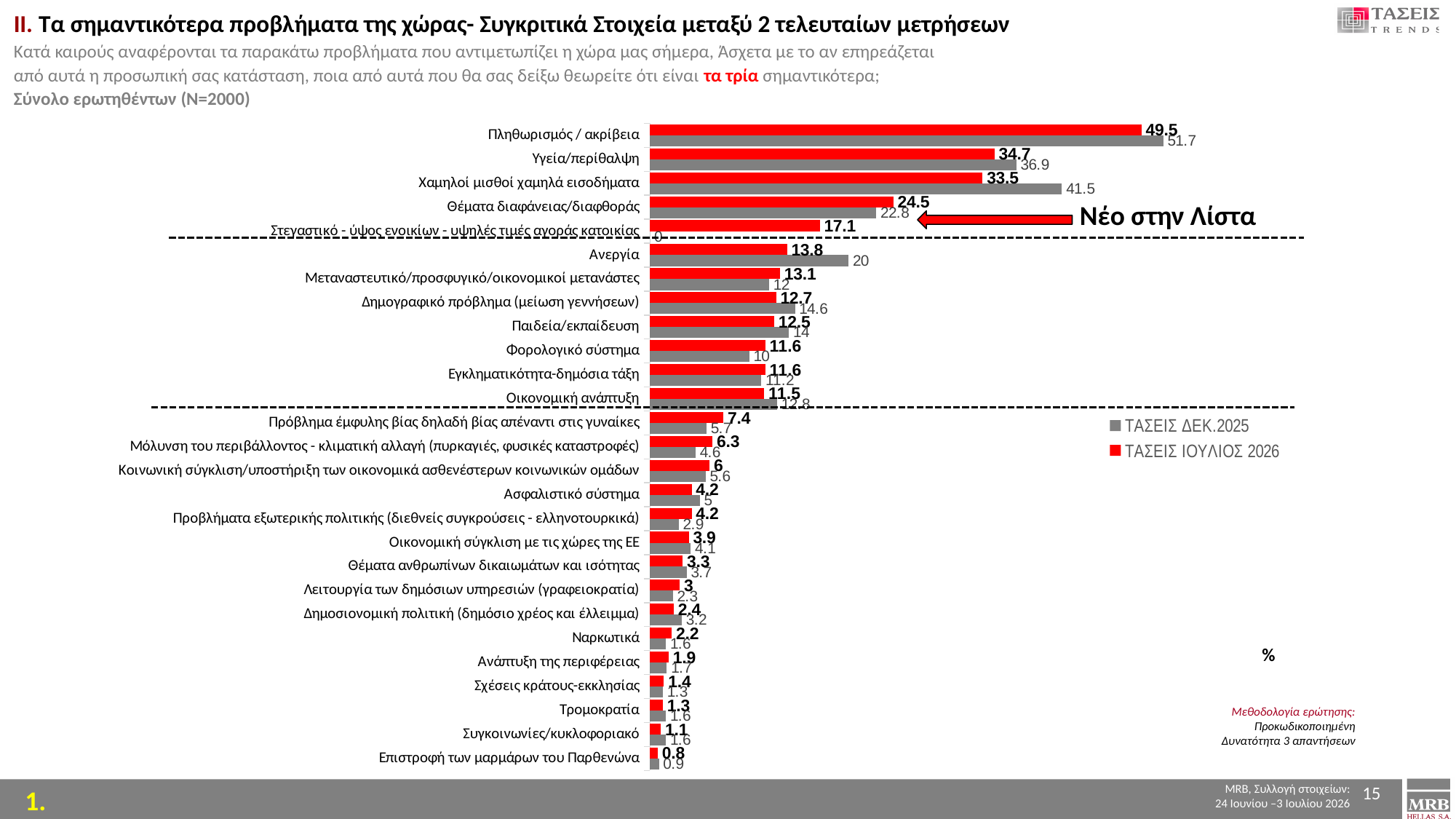
What is the ΤΑΣΕΙΣ ΙΟΥΛΙΟΣ 2026 value for Στεγαστικό - ύψος ενοικίων - υψηλές τιμές αγοράς κατοικίας? 17.1 What type of chart is shown on the slide? bar chart Which category has the lowest ΤΑΣΕΙΣ ΙΟΥΛΙΟΣ 2026 value? Επιστροφή των μαρμάρων του Παρθενώνα How many series does the legend list? 2 What is the difference between the ΤΑΣΕΙΣ ΔΕΚ.2025 and ΤΑΣΕΙΣ ΙΟΥΛΙΟΣ 2026 values for Ανεργία? 6.2 For Θέματα διαφάνειας/διαφθοράς, which is larger: the ΤΑΣΕΙΣ ΔΕΚ.2025 value or the ΤΑΣΕΙΣ ΙΟΥΛΙΟΣ 2026 value? ΤΑΣΕΙΣ ΙΟΥΛΙΟΣ 2026 What is the ΤΑΣΕΙΣ ΔΕΚ.2025 value for Φορολογικό σύστημα? 10 Which colour represents the ΤΑΣΕΙΣ ΙΟΥΛΙΟΣ 2026 series? red Which category has the highest ΤΑΣΕΙΣ ΙΟΥΛΙΟΣ 2026 value? Πληθωρισμός / ακρίβεια What is the ΤΑΣΕΙΣ ΔΕΚ.2025 value for Χαμηλοί μισθοί χαμηλά εισοδήματα? 41.5 What is the ΤΑΣΕΙΣ ΙΟΥΛΙΟΣ 2026 value for Πληθωρισμός / ακρίβεια? 49.5 What is the difference between the ΤΑΣΕΙΣ ΔΕΚ.2025 and ΤΑΣΕΙΣ ΙΟΥΛΙΟΣ 2026 values for Υγεία/περίθαλψη? 2.2